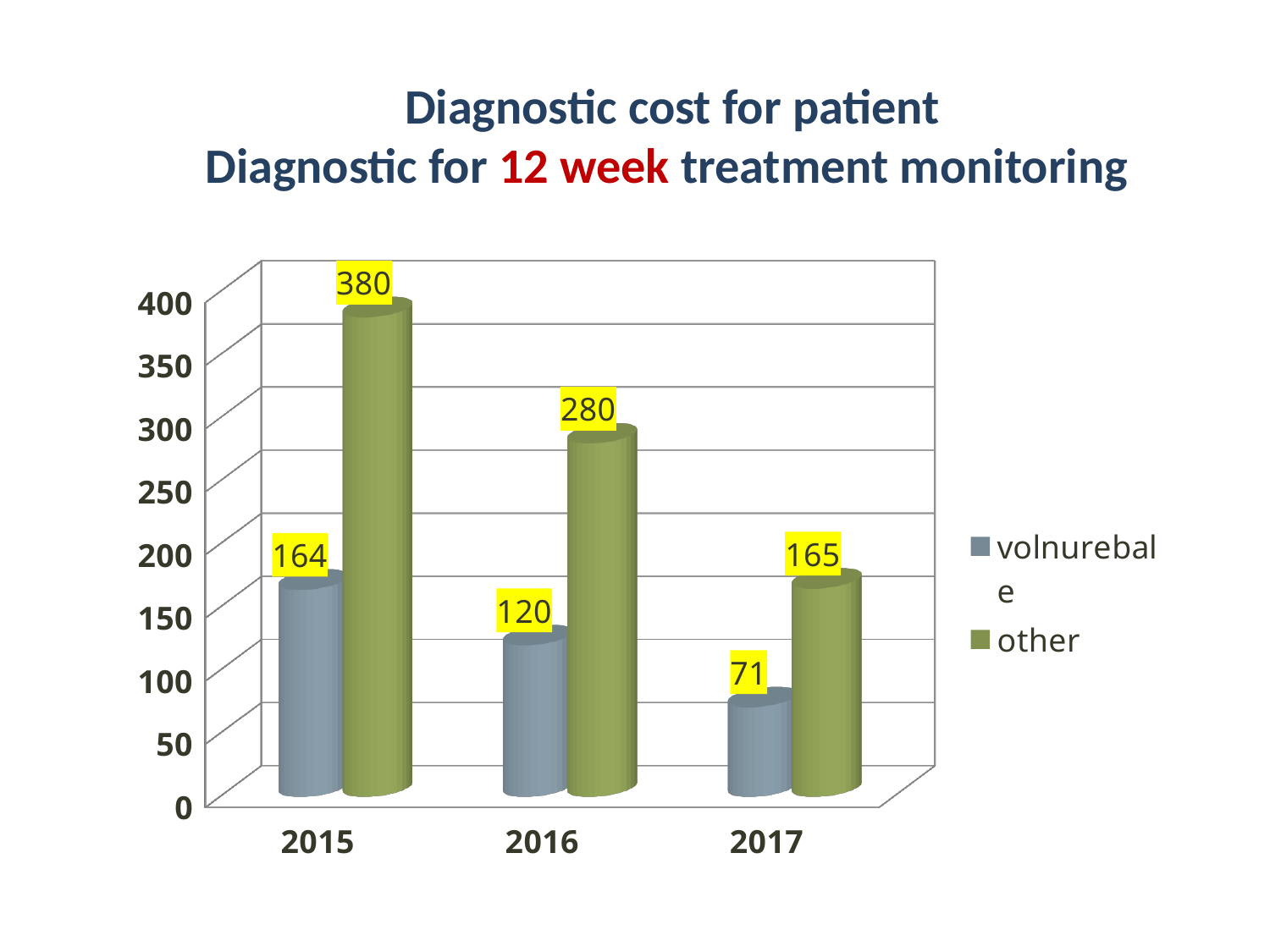
What is the value for 'volnurebale' in 2015? 164 How many series does the legend list? 2 What kind of chart is shown on the slide? bar chart What is the value for 'volnurebale' in 2017? 71 What is the difference between 'other' and 'volnurebale' in 2015? 216 In which year is the 'other' series highest? 2015 Which is larger in 2017, 'volnurebale' or 'other'? other What is the value for 'other' in 2016? 280 What is the difference between the 'other' values for 2016 and 2017? 115 In which year is the 'volnurebale' series lowest? 2017 Do the 'other' values rise or fall from 2015 to 2017? fall How many years are shown on the x axis? 3